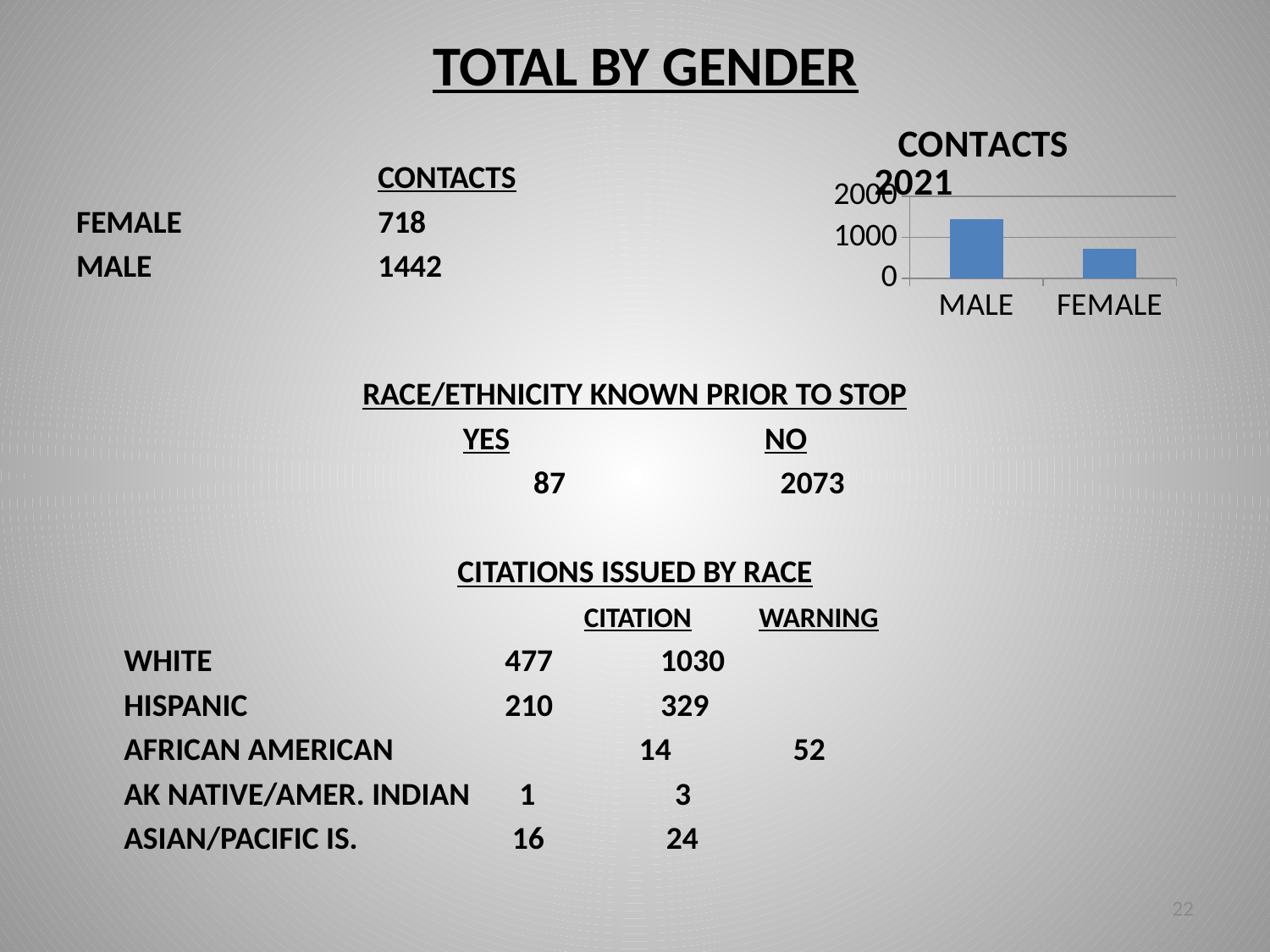
How many categories does the CONTACTS 2021 chart show? 2 In the CONTACTS 2021 chart, is the value for MALE greater or less than 1000? greater What kind of chart is the CONTACTS 2021 chart? bar chart According to the slide, how many contacts were MALE in the CONTACTS 2021 chart? 1442 In the CONTACTS 2021 chart, which is larger, the bar for MALE or the bar for FEMALE? MALE In the CONTACTS 2021 chart, is the value for MALE greater or less than 2000? less What is the title of the bar chart on the slide? CONTACTS 2021 Which category has the lowest bar in the CONTACTS 2021 chart? FEMALE In the CONTACTS 2021 chart, is the value for FEMALE greater or less than 1000? less According to the slide, how many contacts were FEMALE in the CONTACTS 2021 chart? 718 Which category has the highest bar in the CONTACTS 2021 chart? MALE What is the highest value shown on the vertical axis of the CONTACTS 2021 chart? 2000